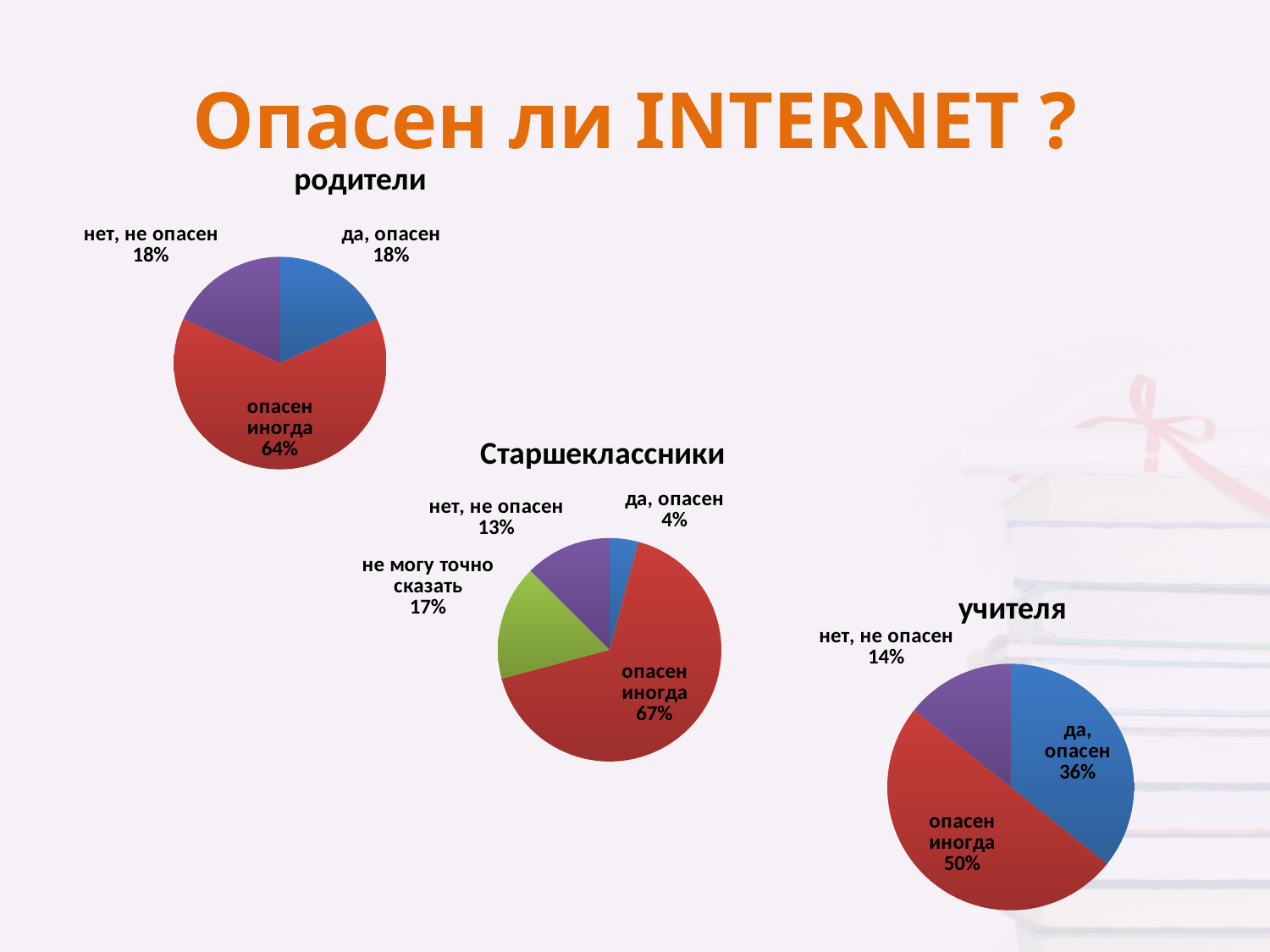
What type of chart is used for the "родители" data? pie chart In the "родители" pie chart, what share is labelled "да, опасен"? 18% In the "учителя" pie chart, what is the difference between the "да, опасен" share and the "нет, не опасен" share? 22% In the "Старшеклассники" pie chart, which category has the smallest share? да, опасен In the "Старшеклассники" pie chart, what share is labelled "да, опасен"? 4% In the "учителя" pie chart, which category has the largest share? опасен иногда How many slices does the "Старшеклассники" pie chart have? 4 Which is larger: the "да, опасен" share in the "учителя" chart or the "да, опасен" share in the "родители" chart? учителя In the "родители" pie chart, what share is labelled "опасен иногда"? 64% In the "Старшеклассники" pie chart, what share is labelled "не могу точно сказать"? 17% How many pie charts are shown on the slide? 3 In the "учителя" pie chart, what share is labelled "нет, не опасен"? 14%